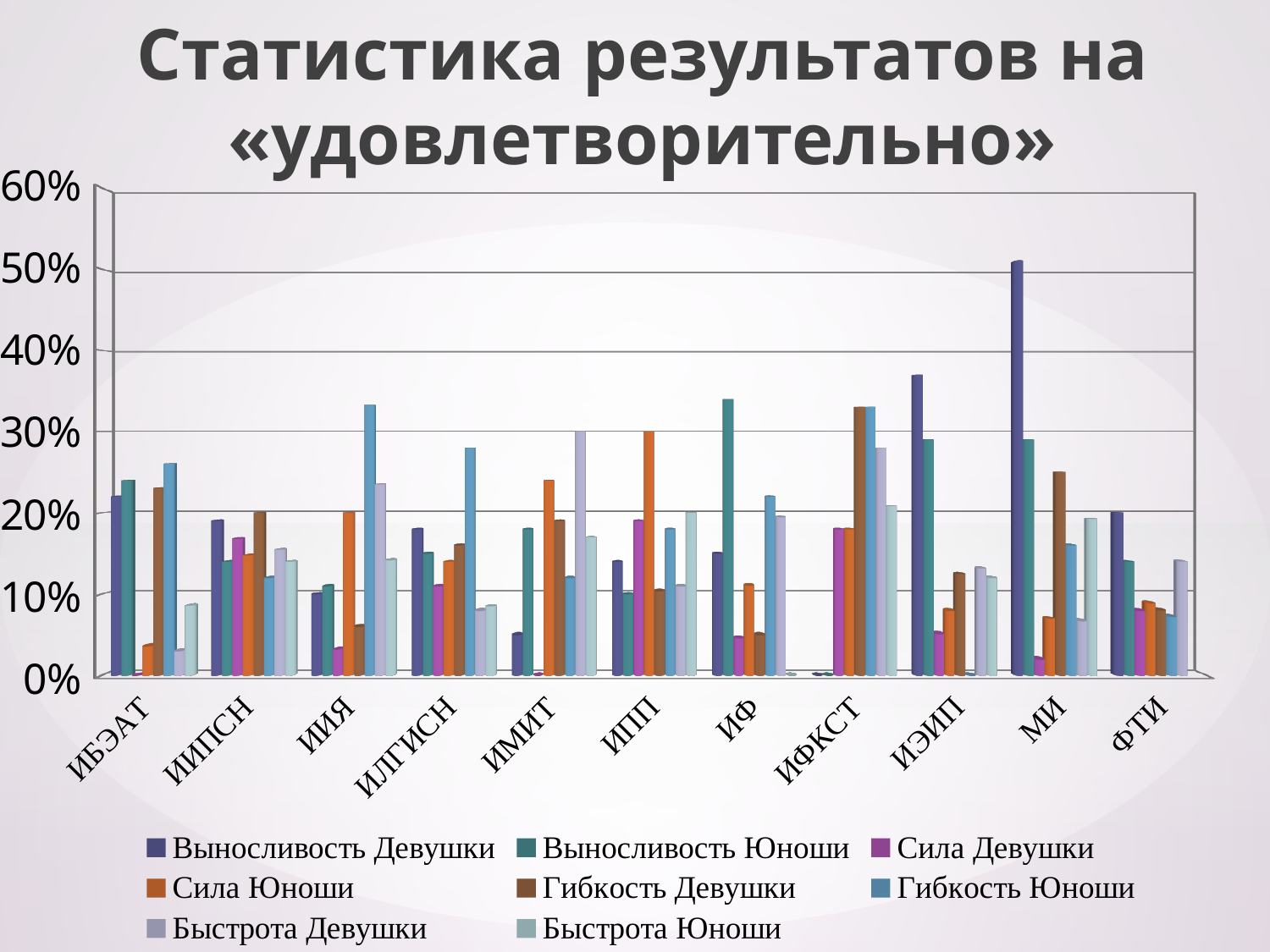
How many series does the legend list? 8 Is the value for Выносливость Девушки at ИЭИП greater or less than 30%? greater How many categories (institutes) are shown along the x axis? 11 Which is larger: Гибкость Юноши at ИИЯ or Гибкость Юноши at ИЛГИСН? ИИЯ Is the value for Выносливость Девушки at ИМИТ greater or less than 10%? less Is the value for Выносливость Девушки at МИ greater or less than 40%? greater Which category has the highest value for Выносливость Девушки? МИ Which is larger: Сила Юноши at ИПП or Сила Юноши at ИМИТ? ИПП What is the title of the chart? Статистика результатов на «удовлетворительно» Which category has the lowest value for Выносливость Девушки? ИФКСТ What kind of chart is shown on the slide? bar chart